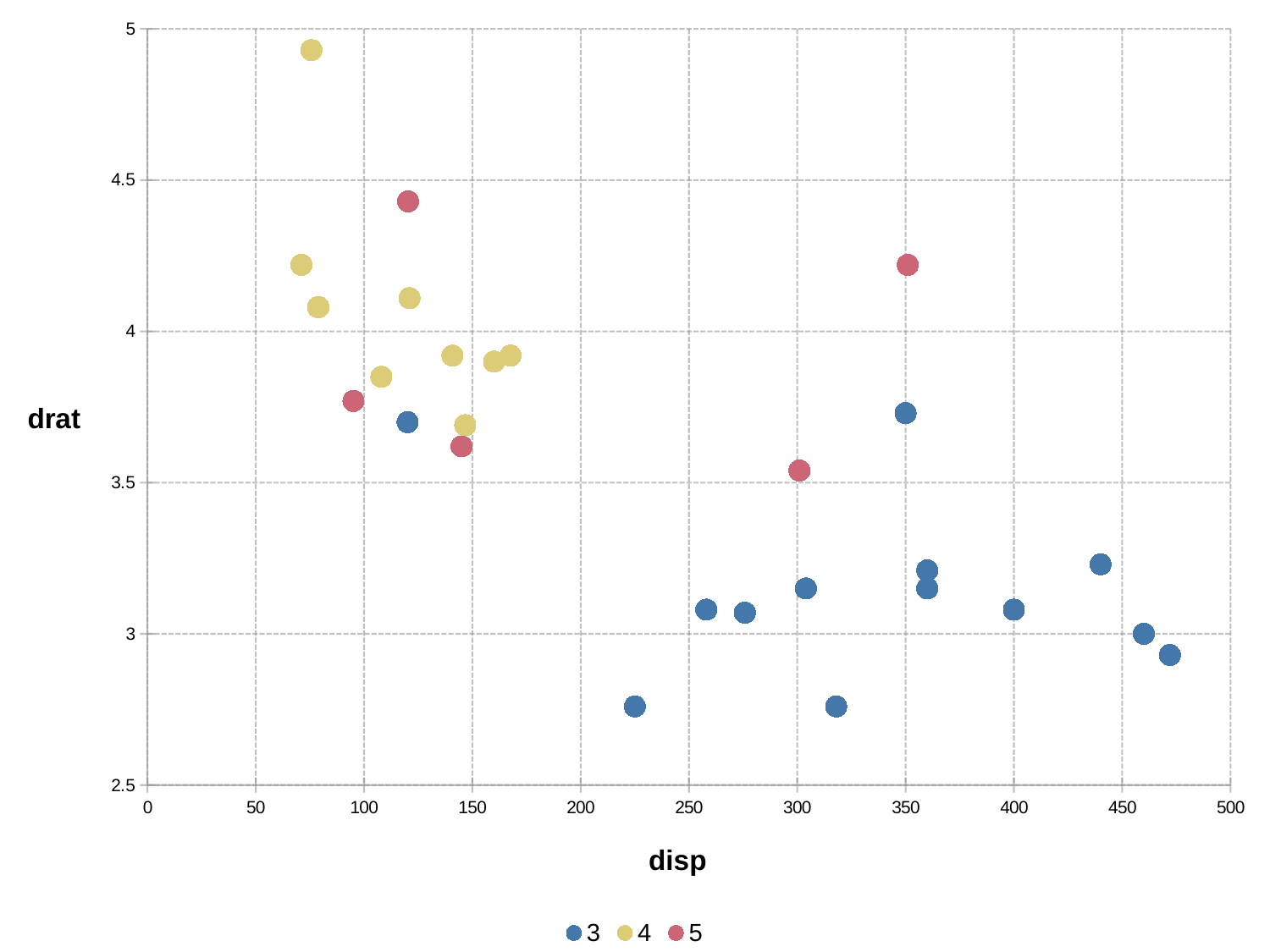
Do drat values generally rise or fall as disp increases? fall How many series does the legend list? 3 Is the drat value of the series 3 point near disp 225 greater or less than 3? less Which series contains the point with the largest disp value? 3 Which series has the point with the lowest drat value? 3 How many points are plotted for series 5? 5 What is the label of the x axis? disp Is the drat value of the highest point in series 4 greater or less than 4.5? greater What kind of chart is shown on the slide? scatter plot Which series contains the point with the highest drat value? 4 Is the drat value of the series 5 point near disp 350 greater or less than 4? greater What are the legend entries of the chart? 3, 4, 5